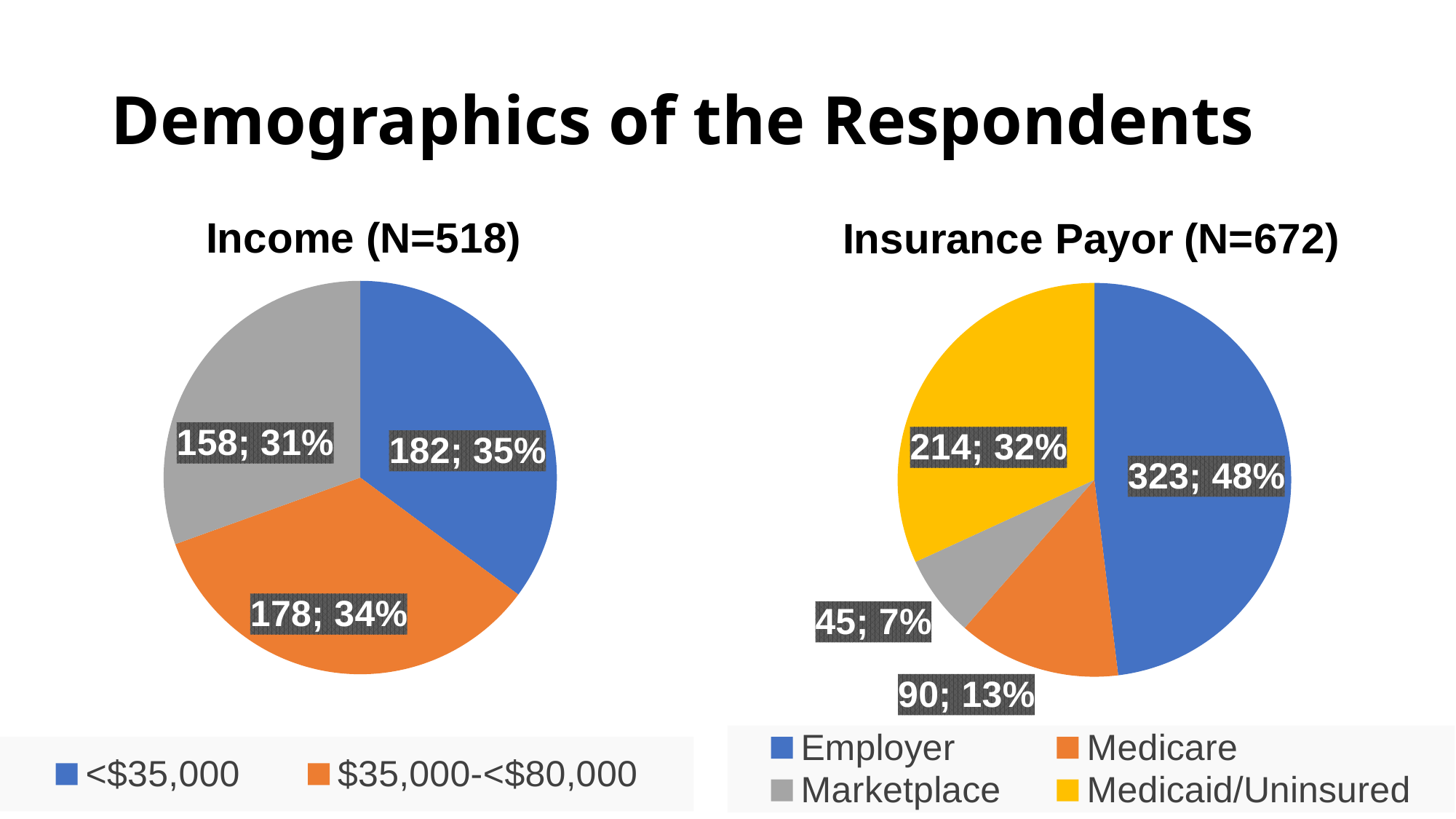
In the Insurance Payor (N=672) chart, what share of the pie is Medicaid/Uninsured? 32% In the Income (N=518) chart, which of the two legend categories has the larger value, <$35,000 or $35,000-<$80,000? <$35,000 In the Income (N=518) chart, how many slices does the pie have? 3 In the Income (N=518) chart, what share of the pie is the $35,000-<$80,000 slice? 34% In the Insurance Payor (N=672) chart, which category has the smallest slice? Marketplace In the Income (N=518) chart, what is the difference in count between the <$35,000 slice and the $35,000-<$80,000 slice? 4 In the Insurance Payor (N=672) chart, what is the value for Marketplace? 45; 7% In the Insurance Payor (N=672) chart, what is the value for Employer? 323; 48% In the Insurance Payor (N=672) chart, what is the difference in count between Medicare and Marketplace? 45 In the Income (N=518) chart, what is the value for the <$35,000 slice? 182; 35% What type of chart is the Insurance Payor (N=672) chart? Pie chart In the Insurance Payor (N=672) chart, which category has the largest slice? Employer